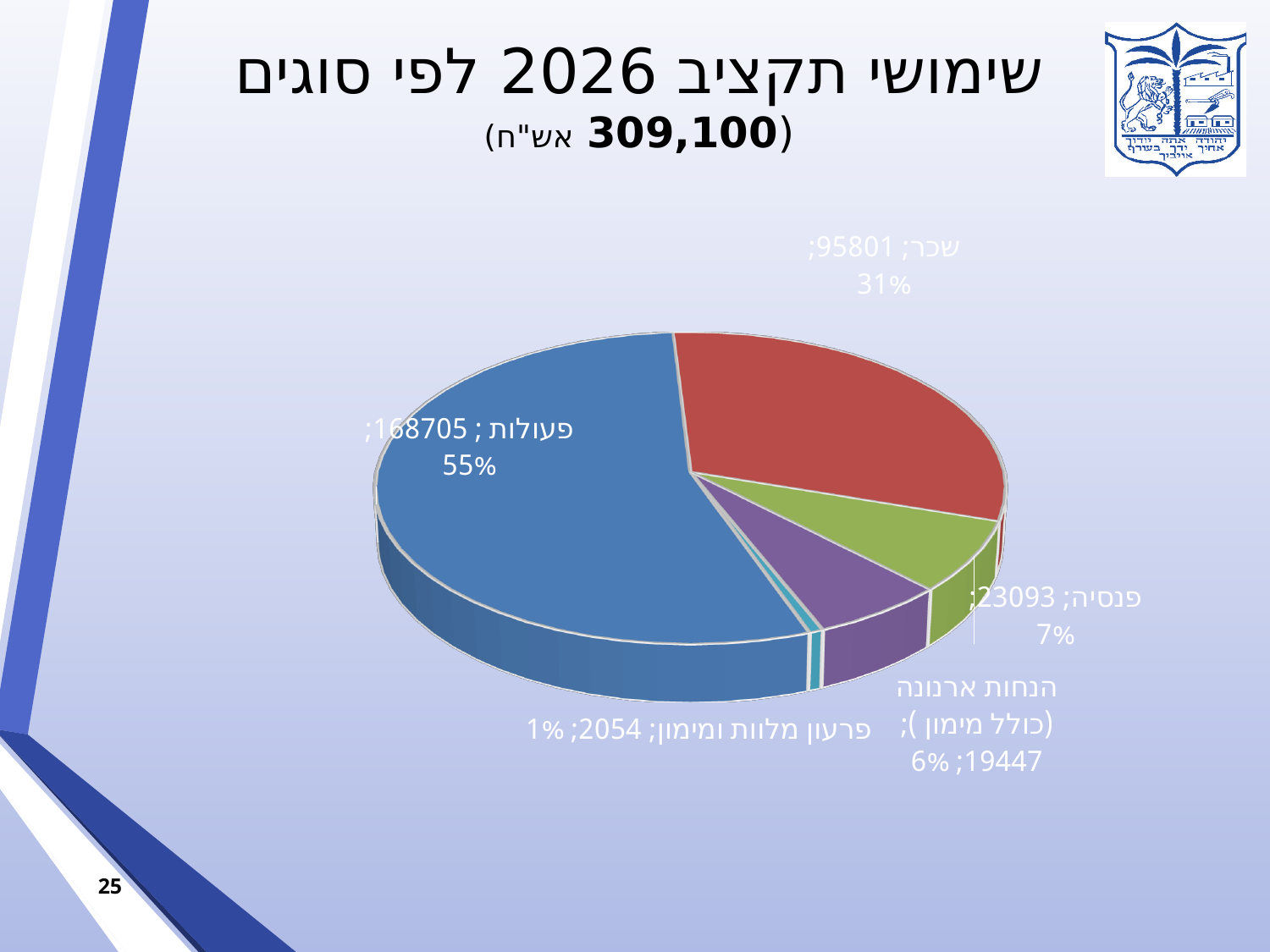
Which is larger, the value for פנסיה or the value for הנחות ארנונה (כולל מימון)? פנסיה What is the value shown for פנסיה? 23093 What is the value shown for הנחות ארנונה (כולל מימון)? 19447 What percentage share of the pie does שכר have? 31% How many slices does the pie chart have? 5 Which category has the largest slice of the pie? פעולות Which category has the smallest slice of the pie? פרעון מלוות ומימון What percentage share of the pie does פרעון מלוות ומימון have? 1% What type of chart is shown on the slide? pie chart What is the value shown for פעולות? 168705 What is the difference between the values for פעולות and שכר? 72904 What is the value shown for שכר? 95801